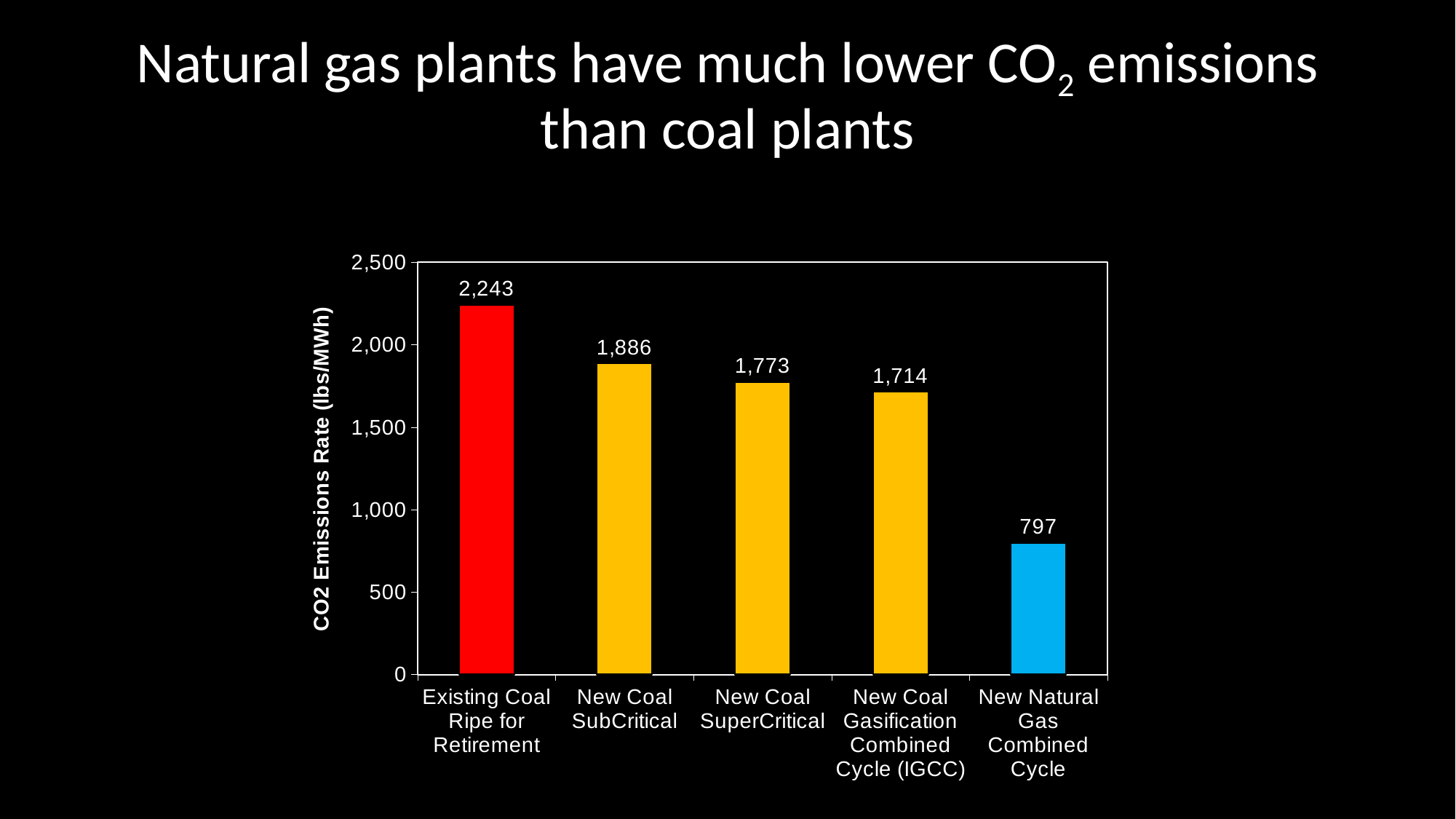
Which has a higher CO2 emissions rate, New Coal SubCritical or New Coal SuperCritical? New Coal SubCritical What is the difference in CO2 emissions rate between New Coal SubCritical and New Natural Gas Combined Cycle? 1,089 Is the value for New Natural Gas Combined Cycle greater or less than 1,000? less What kind of chart is shown on the slide? bar chart Which category has the highest CO2 emissions rate? Existing Coal Ripe for Retirement What is the label of the vertical axis? CO2 Emissions Rate (lbs/MWh) What is the CO2 emissions rate for New Coal SuperCritical? 1,773 What is the CO2 emissions rate for Existing Coal Ripe for Retirement? 2,243 What is the difference in CO2 emissions rate between Existing Coal Ripe for Retirement and New Coal Gasification Combined Cycle (IGCC)? 529 Which category has the lowest CO2 emissions rate? New Natural Gas Combined Cycle What is the CO2 emissions rate for New Natural Gas Combined Cycle? 797 How many categories are shown on the x axis? 5